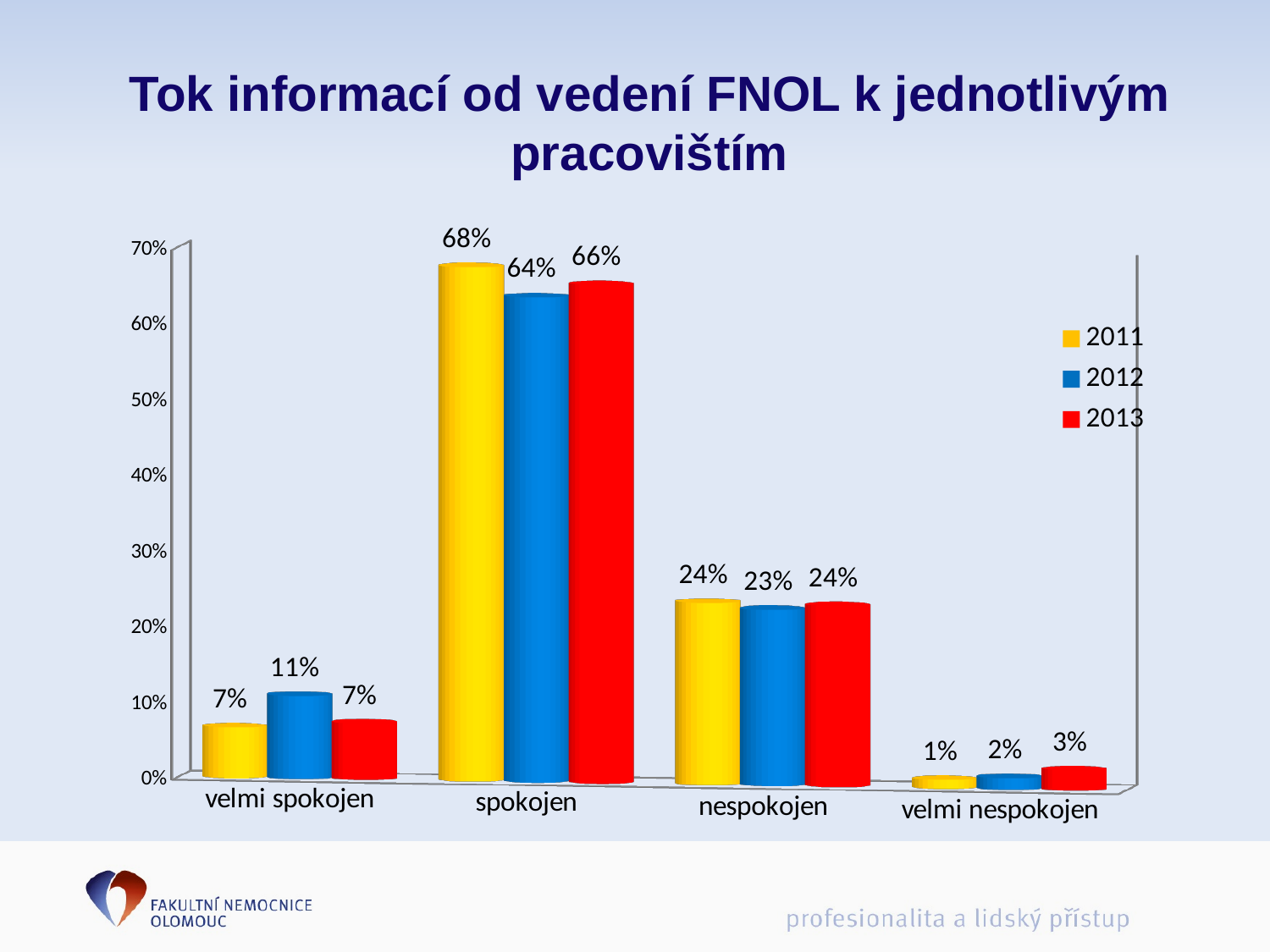
What kind of chart is shown on the slide? bar chart What is the value for 'velmi nespokojen' in 2013? 3% How many series does the legend list? 3 Which is larger for 'velmi spokojen': the 2012 value or the 2013 value? 2012 Which category has the lowest value in 2011? velmi nespokojen How many categories are shown on the x axis? 4 What is the value for 'velmi spokojen' in 2012? 11% What is the difference between the 2011 and 2012 values for 'spokojen'? 4% What is the value for 'nespokojen' in 2012? 23% Which category has the highest value in 2013? spokojen What is the value for 'spokojen' in 2011? 68% Which colour represents the 2013 series in the legend? red